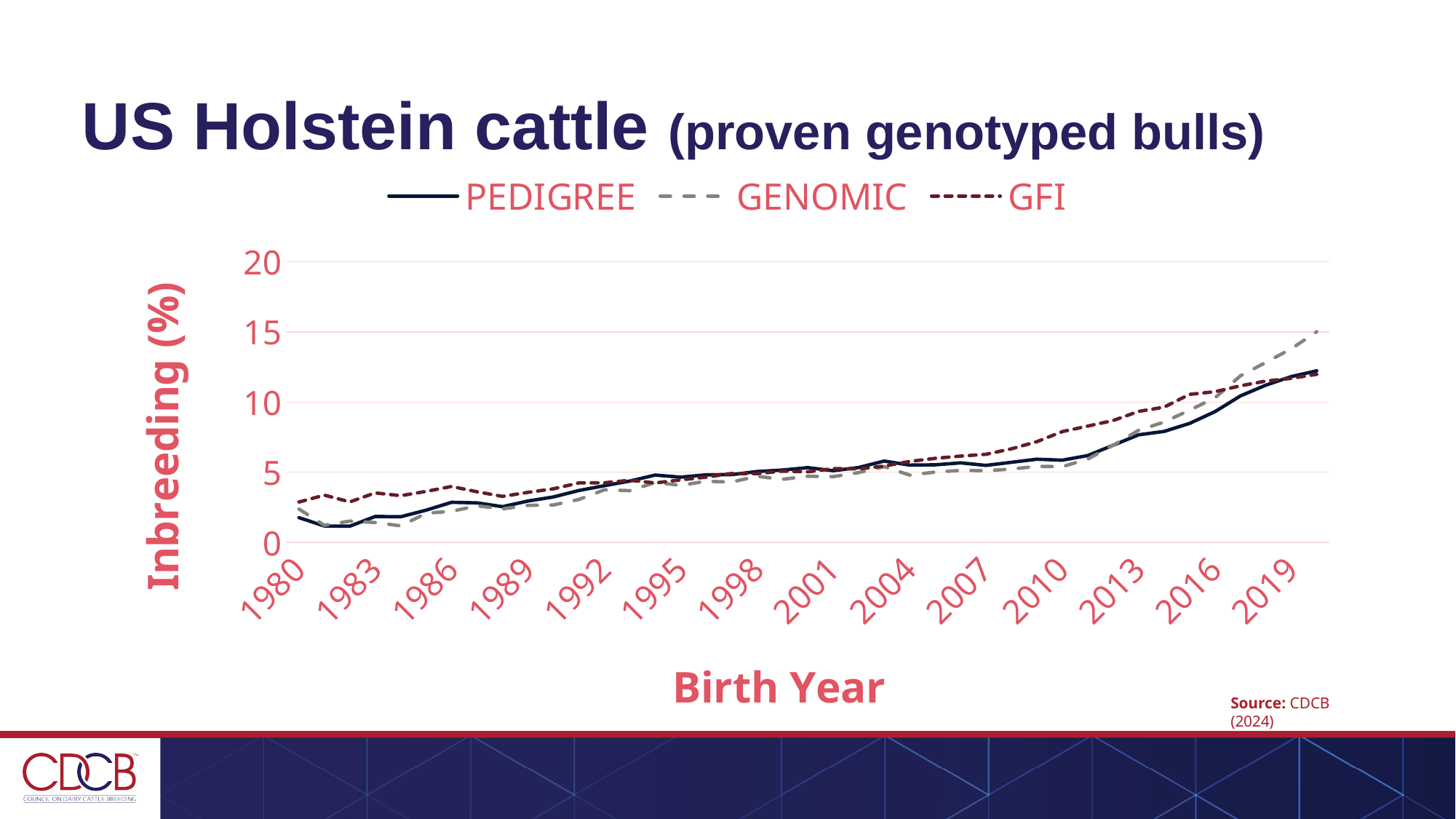
Which series reaches the highest value at the right end of the chart? GENOMIC Is the GENOMIC value at 2019 greater or less than 10? greater What is the label of the y axis? Inbreeding (%) Is the PEDIGREE value at 1980 greater or less than 5? less Is the GFI value at 2010 greater or less than 10? less Do the PEDIGREE values generally rise or fall from 1980 to 2019? rise At 1980, which series has the higher value, GFI or PEDIGREE? GFI What kind of chart is shown on the slide? line chart How many series does the legend list? 3 How many year labels are shown on the x axis? 14 At 2019, which series has the higher value, GENOMIC or PEDIGREE? GENOMIC What are the three series named in the legend? PEDIGREE, GENOMIC, GFI